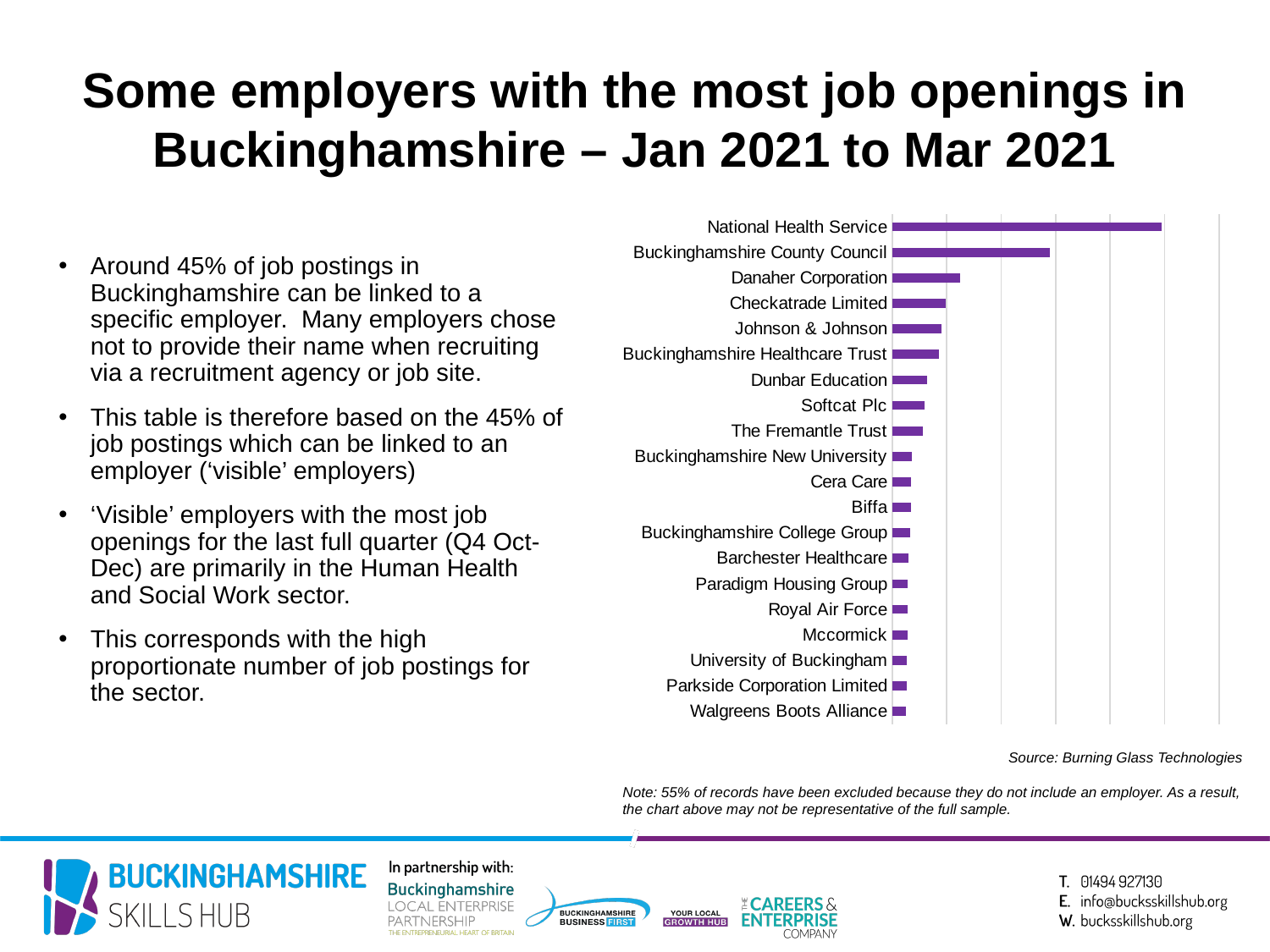
Which employer is listed at the bottom of the chart? Walgreens Boots Alliance Which has the longer bar, National Health Service or Buckinghamshire County Council? National Health Service Which has the longer bar, Buckinghamshire County Council or Danaher Corporation? Buckinghamshire County Council How many employers are listed in the bar chart? 20 Which has the longer bar, Dunbar Education or Buckinghamshire New University? Dunbar Education Do the bars get shorter or longer going from the top of the chart to the bottom? Shorter Which employer has the longest bar in the chart? National Health Service What kind of chart is shown on the slide? Bar chart Which employer has the second-longest bar in the chart? Buckinghamshire County Council What colour are the bars in the chart? Purple